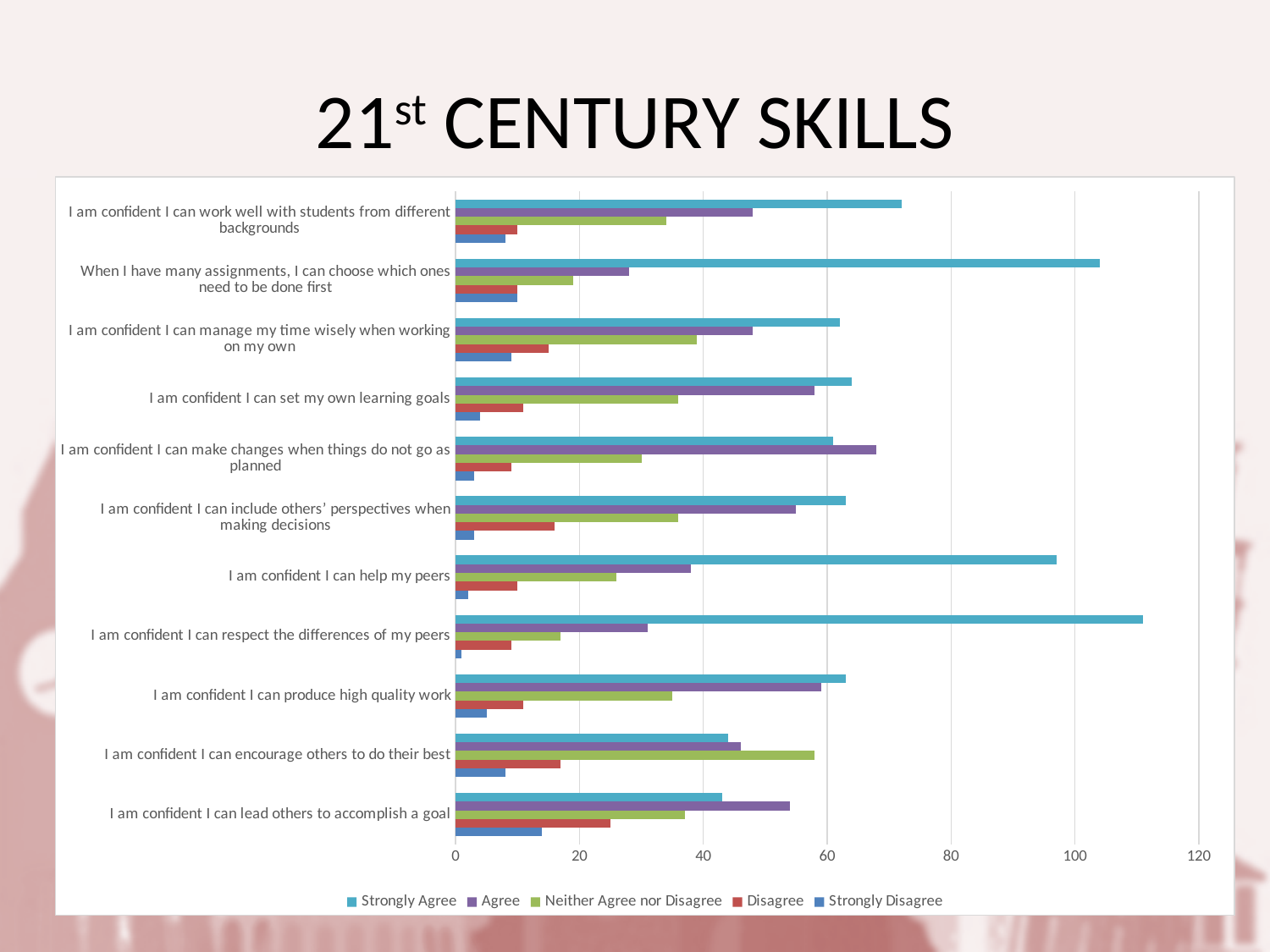
What is the title of the slide containing the chart? 21st CENTURY SKILLS Is the Neither Agree nor Disagree value for "I am confident I can encourage others to do their best" greater or less than 40? greater Is the Strongly Agree value for "I am confident I can respect the differences of my peers" greater or less than 100? greater For "I am confident I can encourage others to do their best", which series has the highest value? Neither Agree nor Disagree For "I am confident I can lead others to accomplish a goal", which is larger: Agree or Strongly Agree? Agree Which statement has the highest Strongly Agree value? I am confident I can respect the differences of my peers For "I am confident I can make changes when things do not go as planned", which is larger: Agree or Strongly Agree? Agree How many statements (categories) are plotted on the chart? 11 Is the Strongly Agree value for "I am confident I can help my peers" greater or less than 80? greater How many series does the legend list? 5 What kind of chart is shown on the slide? bar chart